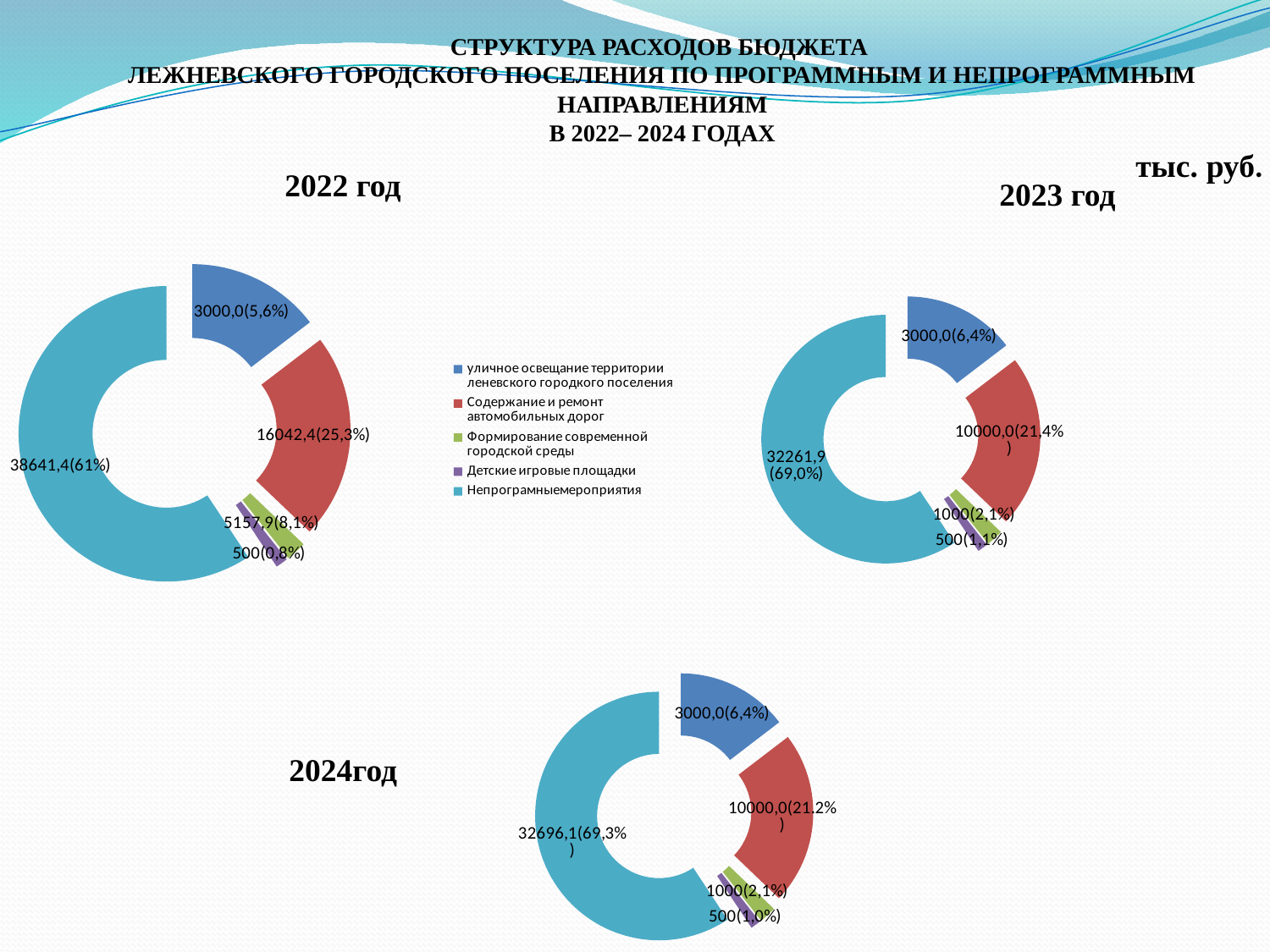
How many charts are shown on the slide? 3 On the 2022 год chart, what is the difference between the values for Содержание и ремонт автомобильных дорог and Формирование современной городской среды? 10884,5 On the 2024год chart, what share of the total does уличное освещение территории represent? 6,4% How many series does the legend list? 5 On the 2023 год chart, what is the value shown for Содержание и ремонт автомобильных дорог? 10000,0(21,4%) On the 2022 год chart, what is the value shown for Непрограмные мероприятия? 38641,4(61%) On the 2024год chart, what is the value shown for Непрограмные мероприятия? 32696,1(69,3%) On the 2023 год chart, which category has the largest value? Непрограмные мероприятия On the 2022 год chart, which category has the smallest value? Детские игровые площадки On the 2023 год chart, which is larger: Формирование современной городской среды or Детские игровые площадки? Формирование современной городской среды On the 2022 год chart, what share of the total does Содержание и ремонт автомобильных дорог represent? 25,3% What kind of chart is used for the 2024год data? Doughnut chart